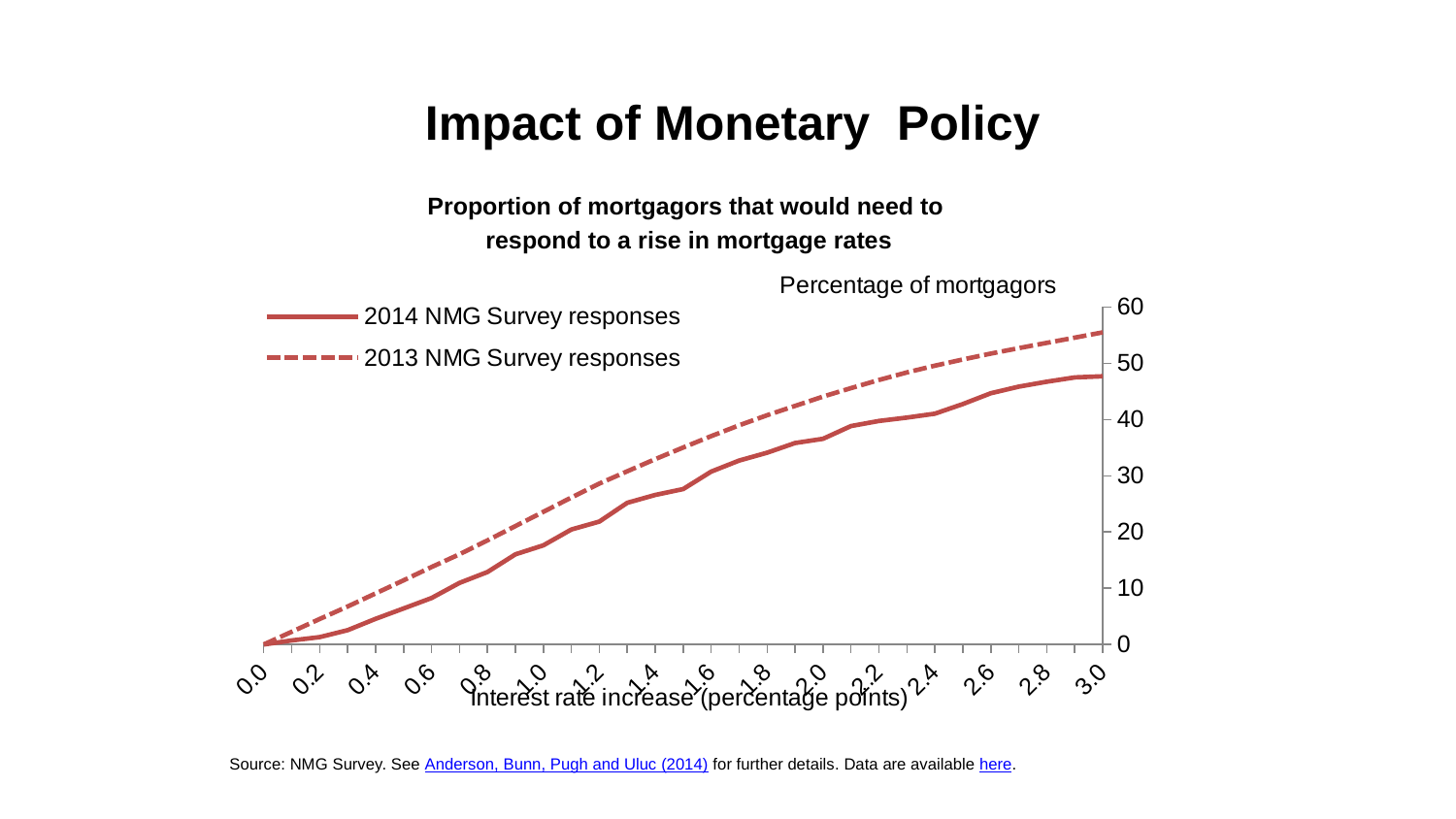
Is the value for the 2013 NMG Survey responses at an interest rate increase of 3.0 greater or less than 50? greater Is the value for the 2014 NMG Survey responses at an interest rate increase of 3.0 greater or less than 50? less Which two series are shown in the legend? 2014 NMG Survey responses and 2013 NMG Survey responses What is the value for the 2014 NMG Survey responses at an interest rate increase of 0.0? 0 Do the values for the 2014 NMG Survey responses rise or fall as the interest rate increase goes from 0.0 to 3.0? rise How many series does the legend list? 2 Is the value for the 2013 NMG Survey responses at an interest rate increase of 2.0 greater or less than 40? greater At an interest rate increase of 3.0 percentage points, which series has the higher value: 2014 NMG Survey responses or 2013 NMG Survey responses? 2013 NMG Survey responses What is the title of the chart? Proportion of mortgagors that would need to respond to a rise in mortgage rates What kind of chart is shown on the slide? line chart Do the values for the 2013 NMG Survey responses rise or fall along the x axis? rise